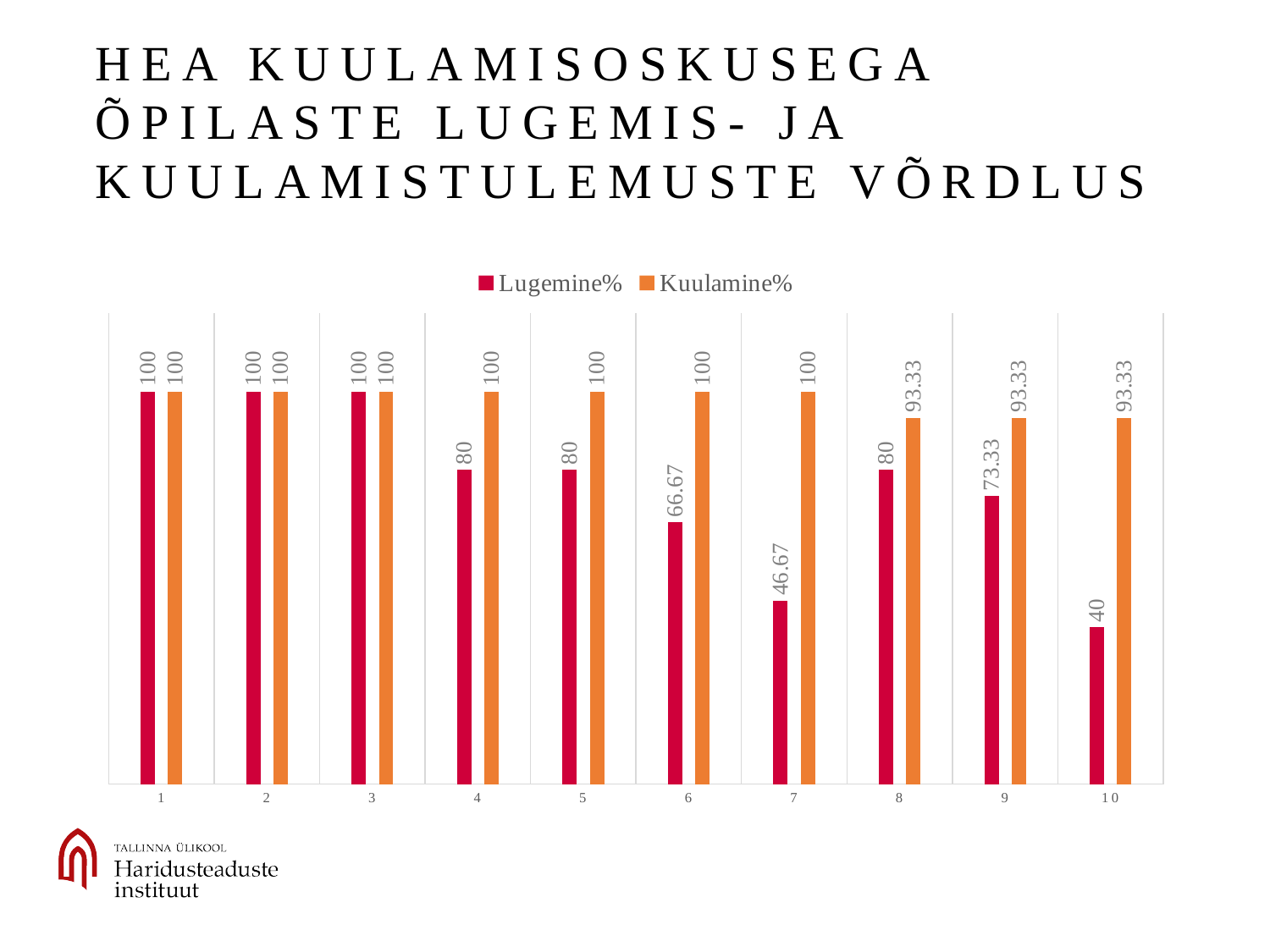
Does the Kuulamine% value rise or fall from category 7 to category 8? fall What kind of chart is shown on the slide? bar chart How many series does the legend list? 2 What is the Kuulamine% value for category 9? 93.33 How many categories are shown on the x axis? 10 For category 8, which series has the larger value, Lugemine% or Kuulamine%? Kuulamine% What is the difference between the Kuulamine% and Lugemine% values for category 7? 53.33 Which category has the lowest Lugemine% value? 10 What is the difference between the Lugemine% values for category 4 and category 6? 13.33 What is the Lugemine% value for category 7? 46.67 Which colour represents the Lugemine% series? red What is the Lugemine% value for category 10? 40